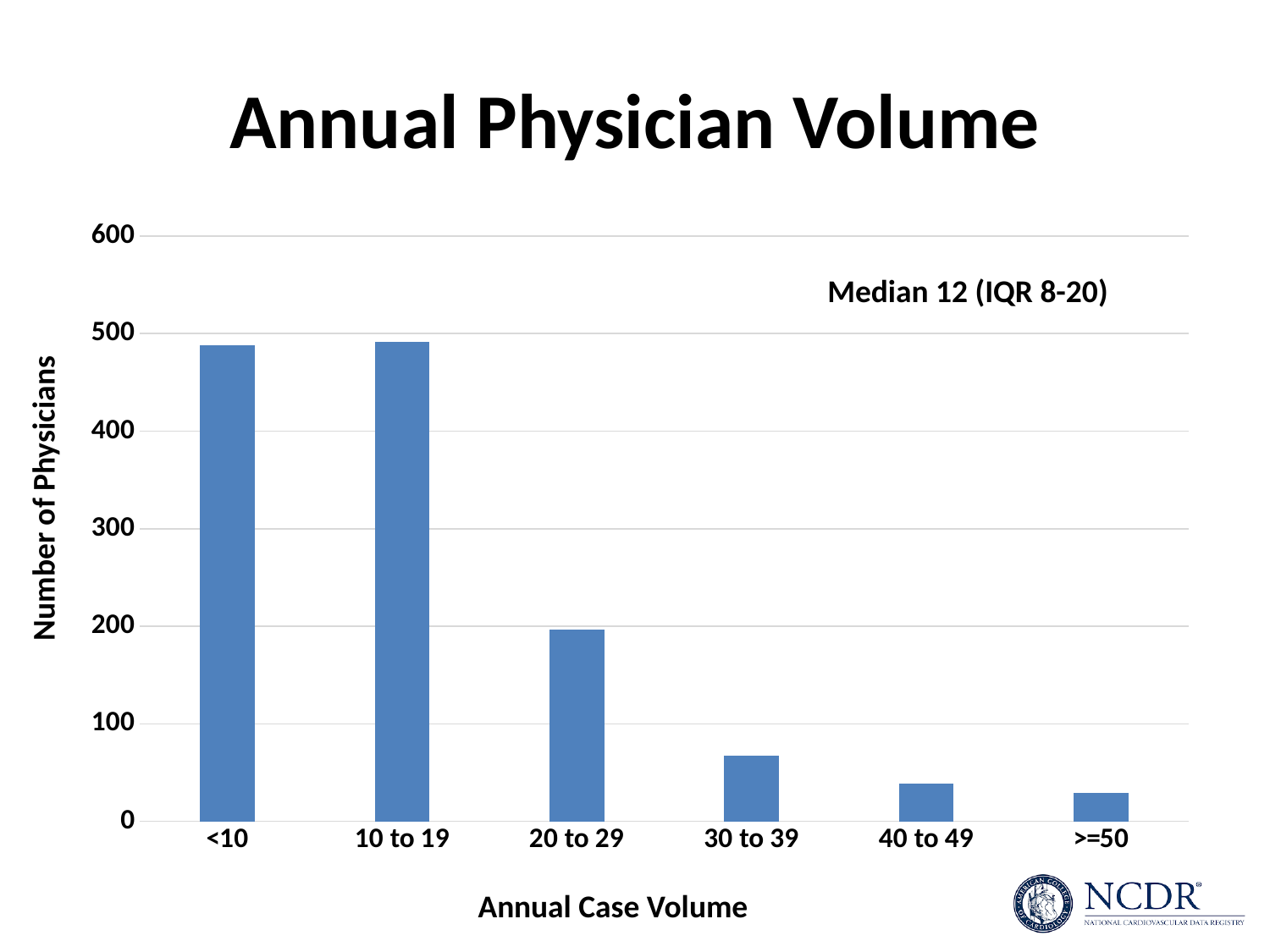
Do the number of physicians generally rise or fall as annual case volume increases along the x axis? fall Is the number of physicians for the 20 to 29 category greater or less than 100? greater Is the number of physicians for the 30 to 39 category greater or less than 100? less What kind of chart is shown on the slide? bar chart Which has more physicians, the 20 to 29 category or the 30 to 39 category? 20 to 29 How many annual case volume categories are shown on the x axis? 6 Is the number of physicians for the <10 category greater or less than 400? greater Which has more physicians, the <10 category or the >=50 category? <10 What median and IQR are annotated on the chart? Median 12 (IQR 8-20) What is the title of the chart? Annual Physician Volume